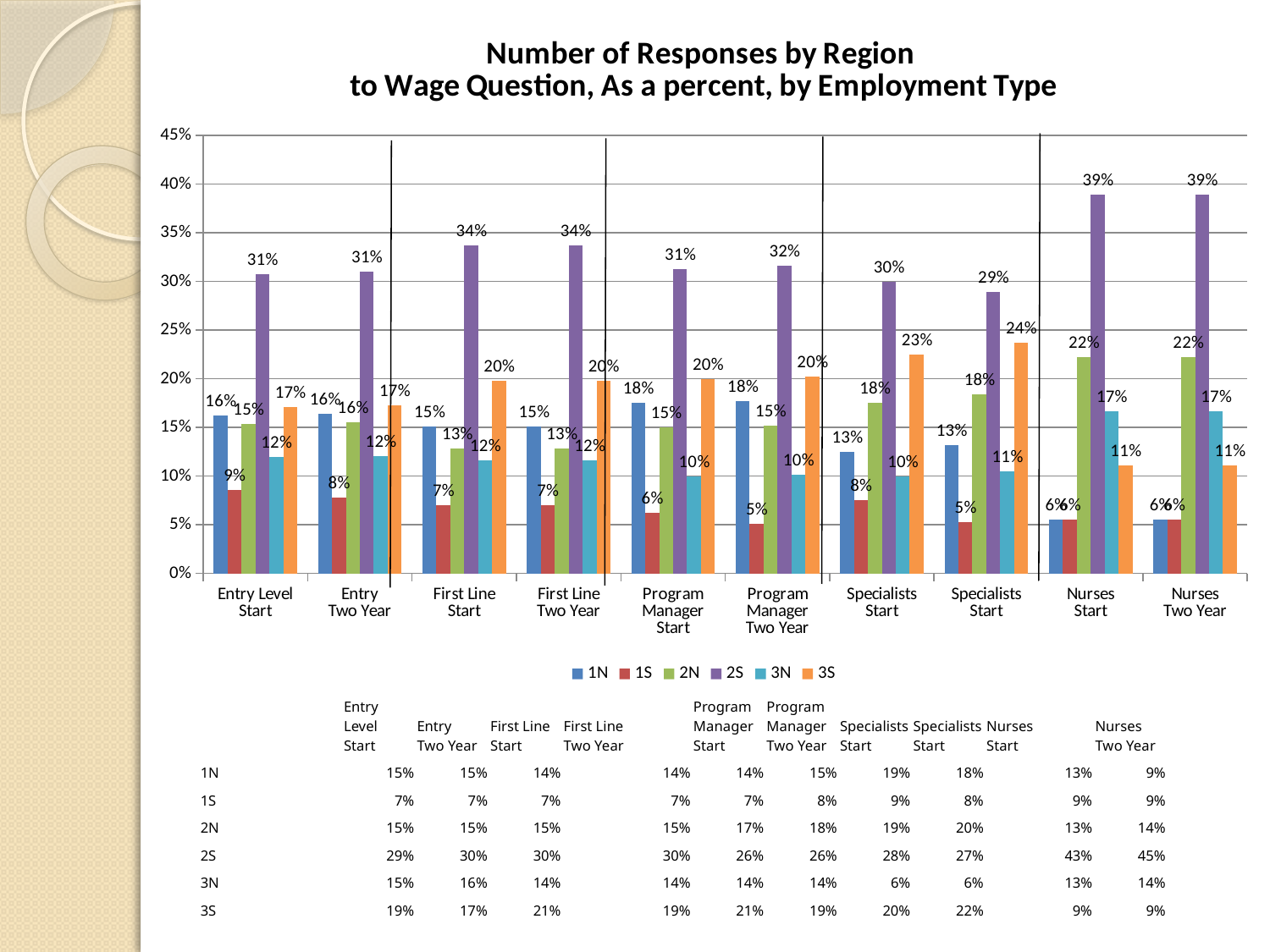
What kind of chart is shown on the slide? bar chart What is the value for series 1S in the Entry Level Start category? 9% How many employment-type categories are shown along the x axis of the chart? 10 In the Program Manager Start category, which is larger: the value for 1N or the value for 2N? 1N Which series has the lowest value in the Program Manager Two Year category? 1S Which series has the highest value in the Entry Level Start category? 2S What is the title of the chart? Number of Responses by Region to Wage Question, As a percent, by Employment Type What is the value for series 3S in the First Line Start category? 20% How many series does the chart's legend list? 6 What is the difference between the 2S value for Nurses Start and the 2S value for Entry Level Start? 8 percentage points What is the value for series 2S in the Nurses Start category? 39% Is the value for series 2S in the First Line Start category greater or less than 30%? greater